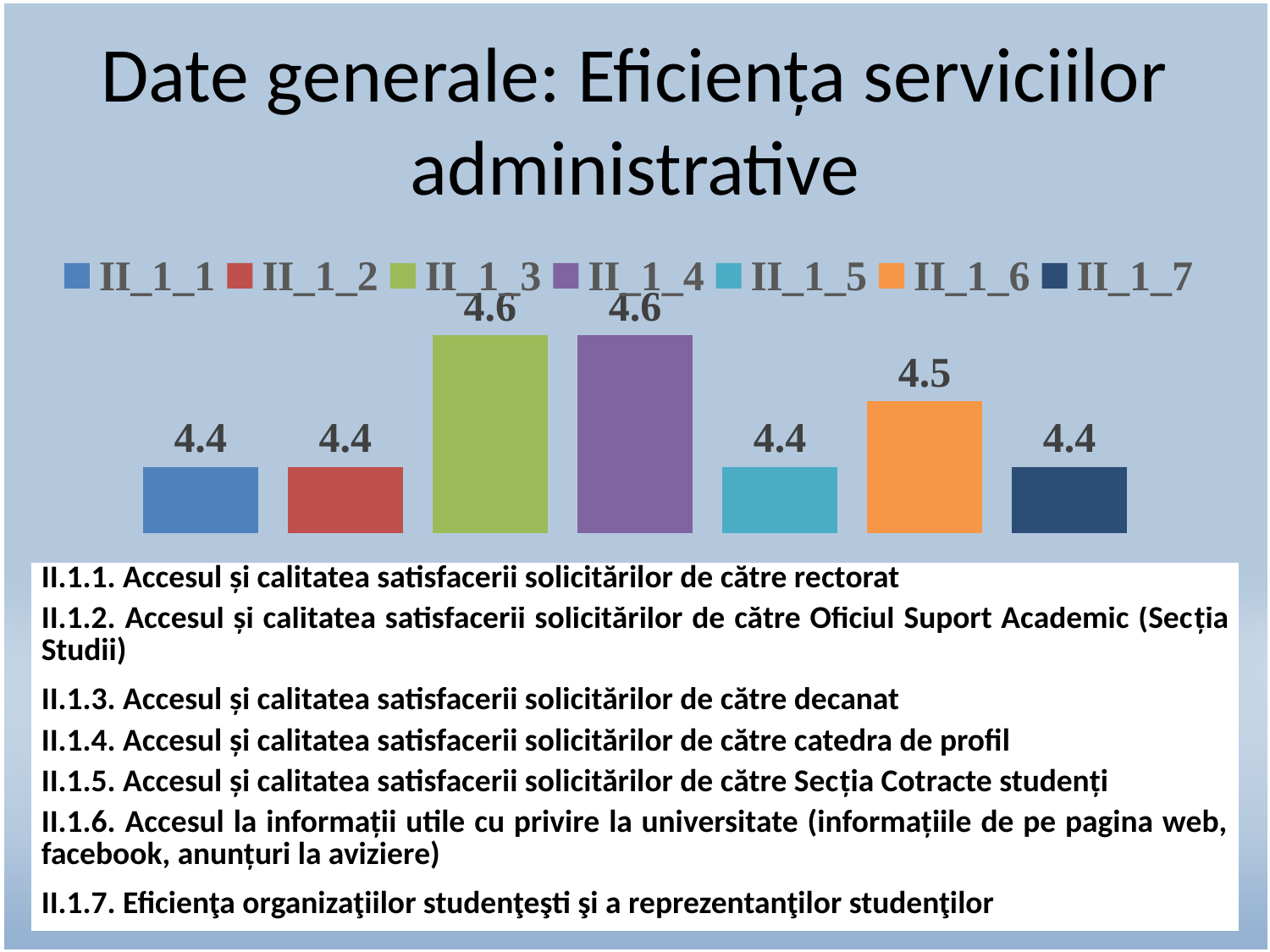
What colour is the bar for II_1_6? Orange Which is larger, the value for II_1_6 or the value for II_1_7? II_1_6 What is the value for II_1_4? 4.6 What is the value for II_1_7? 4.4 What is the difference between the values for II_1_3 and II_1_5? 0.2 What is the value for II_1_6? 4.5 What is the difference between the values for II_1_6 and II_1_2? 0.1 What kind of chart is shown on the slide? Bar chart What is the value for II_1_3? 4.6 What is the value for II_1_1? 4.4 Which two series share the highest value in the chart? II_1_3 and II_1_4 How many series does the legend list? 7